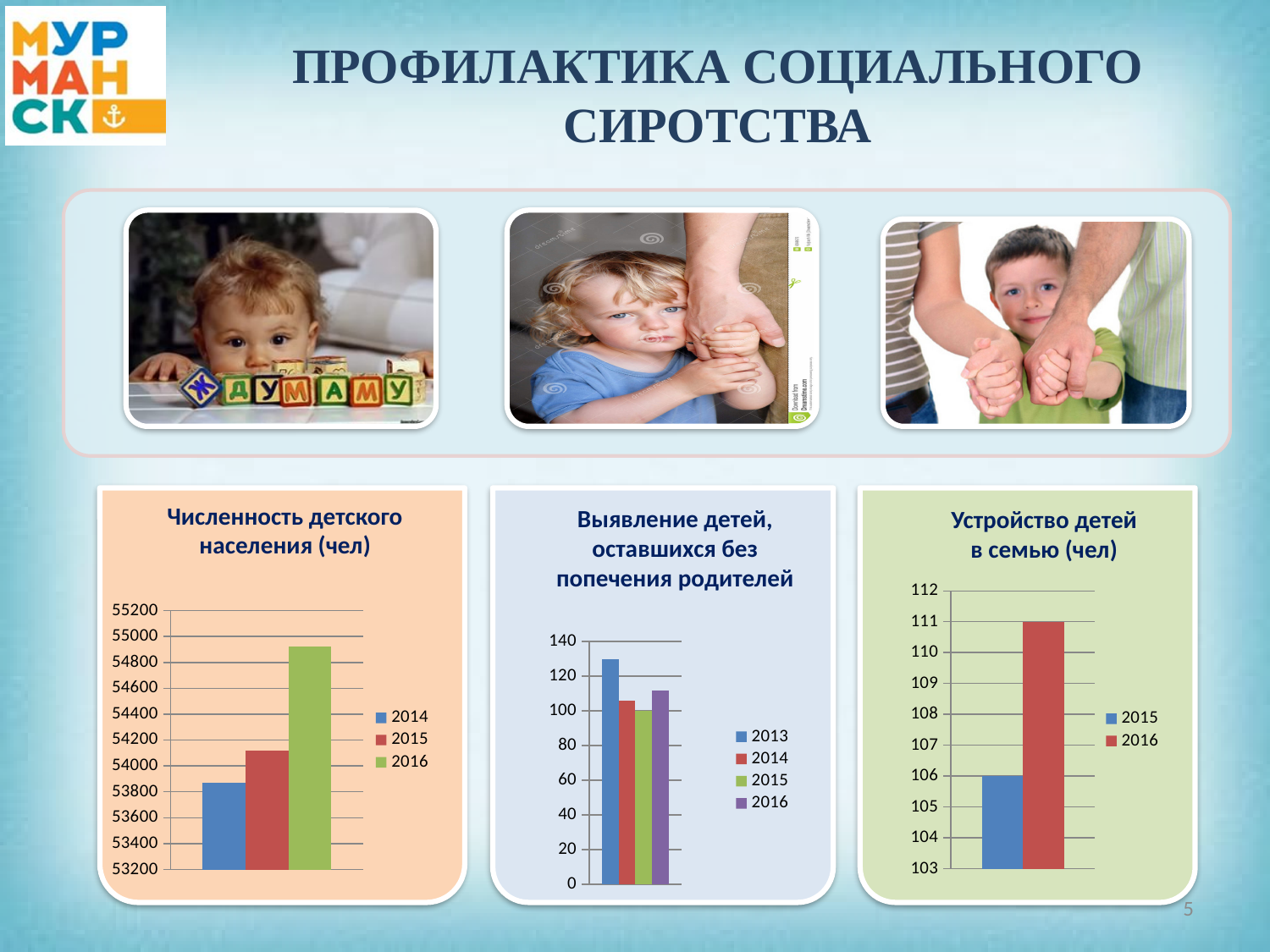
In the chart 'Выявление детей, оставшихся без попечения родителей', which year has the highest value? 2013 In the chart 'Численность детского населения (чел)', which year has the highest value? 2016 In the chart 'Выявление детей, оставшихся без попечения родителей', is the value for 2013 greater or less than 120? greater In the chart 'Устройство детей в семью (чел)', what is the value for 2015? 106 What kind of chart is 'Выявление детей, оставшихся без попечения родителей'? bar chart In the chart 'Устройство детей в семью (чел)', what is the difference between the 2016 and 2015 values? 5 In the chart 'Численность детского населения (чел)', is the value for 2016 greater or less than 54800? greater In the chart 'Выявление детей, оставшихся без попечения родителей', how many series does the legend list? 4 In the chart 'Численность детского населения (чел)', do the values rise or fall from 2014 to 2016? rise In the chart 'Устройство детей в семью (чел)', how many series does the legend list? 2 In the chart 'Численность детского населения (чел)', which year has the lowest value? 2014 In the chart 'Устройство детей в семью (чел)', what is the value for 2016? 111